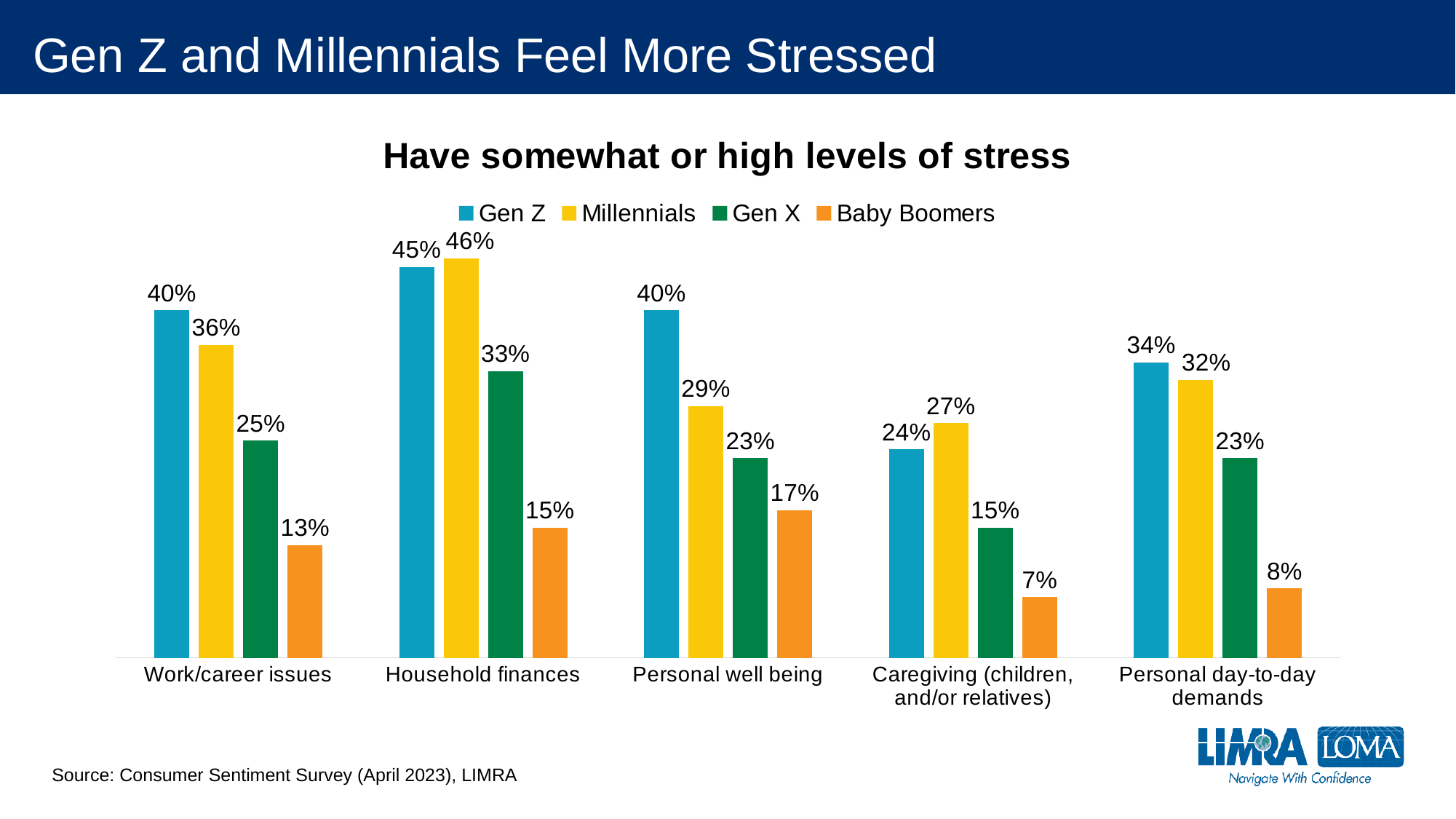
What is the difference between the Gen Z and Baby Boomers values in the Personal well being category? 23% How many series does the legend list? 4 How many categories are shown on the x axis? 5 What is the value for Gen X in the Personal day-to-day demands category? 23% In the Caregiving (children, and/or relatives) category, which is larger: Gen Z or Millennials? Millennials What kind of chart is shown on the slide? Bar chart What is the value for Millennials in the Household finances category? 46% Which category has the highest value for Gen Z? Household finances What is the value for Gen Z in the Work/career issues category? 40% Which category has the lowest value for Baby Boomers? Caregiving (children, and/or relatives) What is the value for Baby Boomers in the Caregiving (children, and/or relatives) category? 7% What is the title of the chart? Have somewhat or high levels of stress